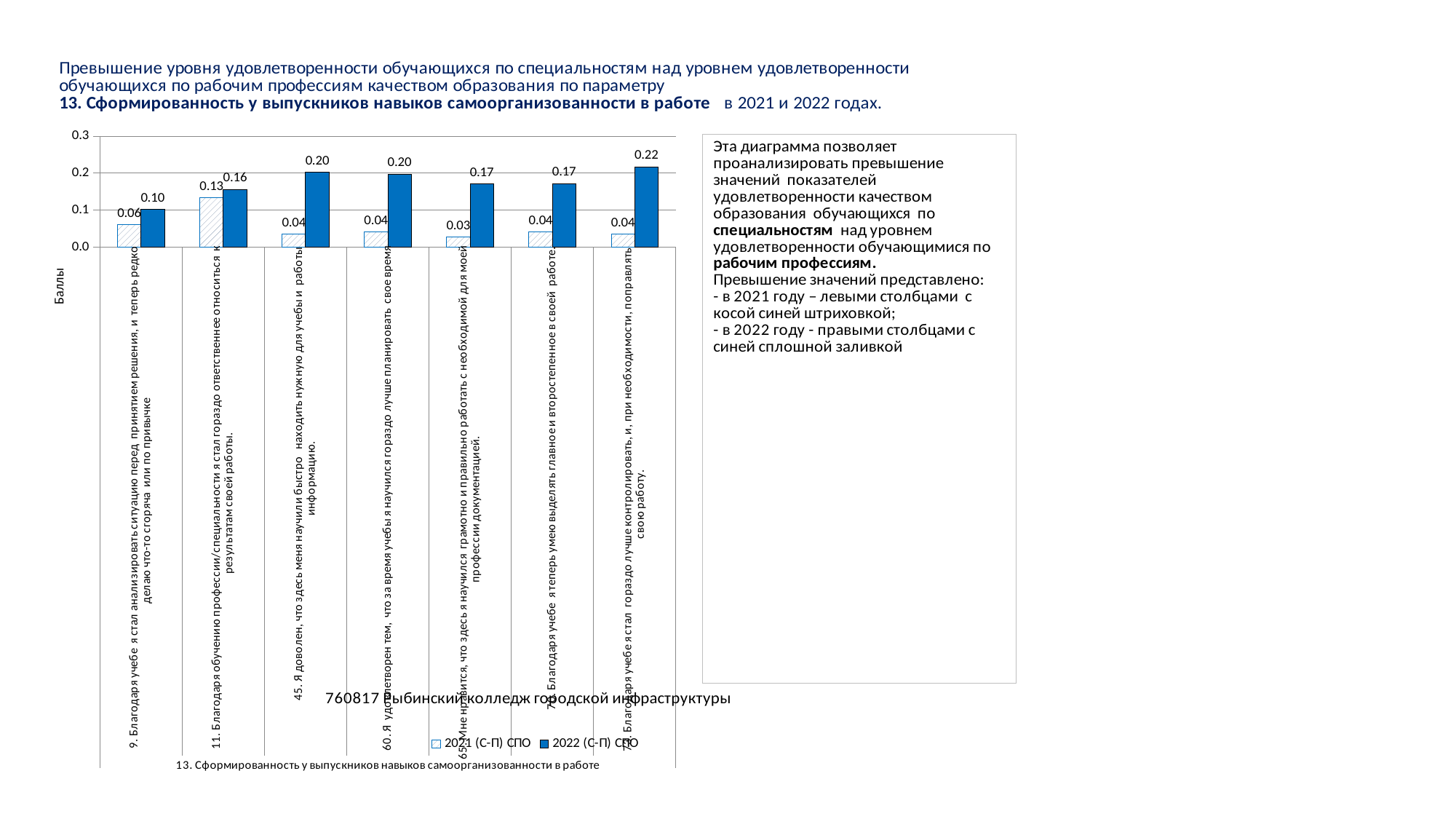
How many series does the chart legend list? 2 What is the 2021 (С-П) СПО value for statement 65 ("Мне нравится, что здесь я научился грамотно и правильно работать с необходимой для моей профессии документацией")? 0.03 What is the label of the vertical axis of the chart? Баллы Which statement has the lowest 2021 (С-П) СПО value? 65. Мне нравится, что здесь я научился грамотно и правильно работать с необходимой для моей профессии документацией (0.03) Which statement has the highest 2022 (С-П) СПО value? Благодаря учебе я стал гораздо лучше контролировать и, при необходимости, поправлять свою работу (0.22) What is the 2022 (С-П) СПО value for statement 9 ("Благодаря учебе я стал анализировать ситуацию перед принятием решения...")? 0.10 What kind of chart is shown on the slide? bar chart What is the difference between the 2022 and 2021 (С-П) СПО values for statement 45? 0.16 How many categories (statements) are plotted on the chart? 7 What is the 2022 (С-П) СПО value for statement 45 ("Я доволен, что здесь меня научили быстро находить нужную для учебы и работы информацию")? 0.20 Which is larger for statement 11: the 2021 (С-П) СПО value or the 2022 (С-П) СПО value? 2022 (С-П) СПО What is the 2021 (С-П) СПО value for statement 11 ("Благодаря обучению профессии/специальности я стал гораздо ответственнее относиться к результатам своей работы")? 0.13